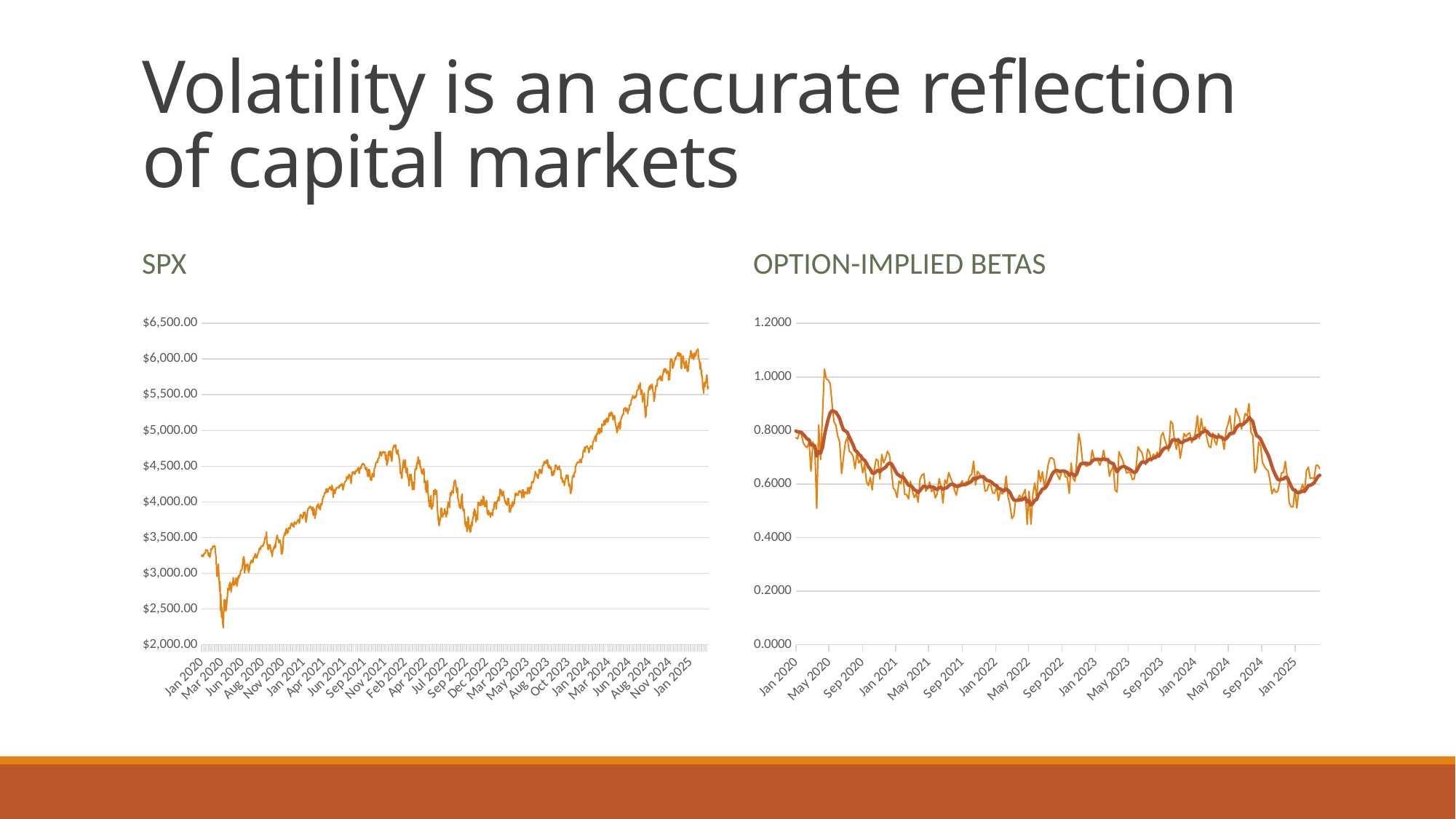
In the OPTION-IMPLIED BETAS chart, do values overall rise or fall from Jan 2020 to Jan 2025? fall In the OPTION-IMPLIED BETAS chart, is the value at Jan 2020 greater or less than 0.6000? greater What kind of chart is the SPX chart? line chart In the OPTION-IMPLIED BETAS chart, is the lowest value reached around May 2022 greater or less than 0.6000? less What kind of chart is the OPTION-IMPLIED BETAS chart? line chart In the SPX chart, do values overall rise or fall from Jan 2020 to Jan 2025? rise What is the title of the chart on the left of the slide? SPX In the SPX chart, is the peak value reached around Jan 2025 greater or less than $6,000.00? greater What is the highest value shown on the y axis of the OPTION-IMPLIED BETAS chart? 1.2000